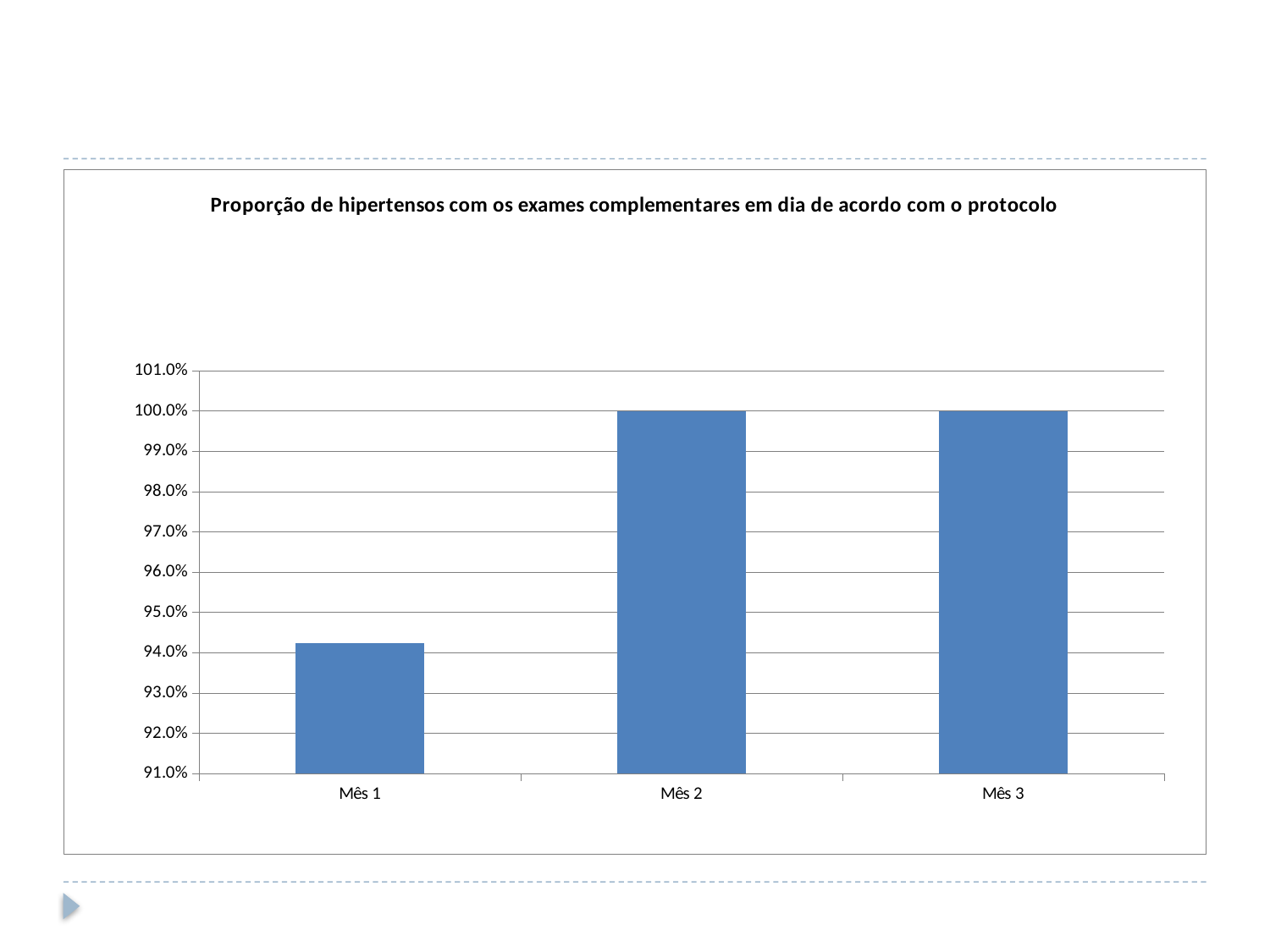
Which is larger, the value for Mês 1 or the value for Mês 2? Mês 2 Which month has the lowest value? Mês 1 What is the value for Mês 2? 100.0% Is the value for Mês 1 greater or less than 95.0%? less What is the lowest value shown on the y axis? 91.0% What kind of chart is shown on the slide? Bar chart What is the value for Mês 3? 100.0% Is the value for Mês 1 greater or less than 93.0%? greater How many months are shown on the x axis? 3 Do the values rise or fall from Mês 1 to Mês 2? Rise What is the title of the chart? Proporção de hipertensos com os exames complementares em dia de acordo com o protocolo What is the difference between the values for Mês 2 and Mês 3? 0.0%